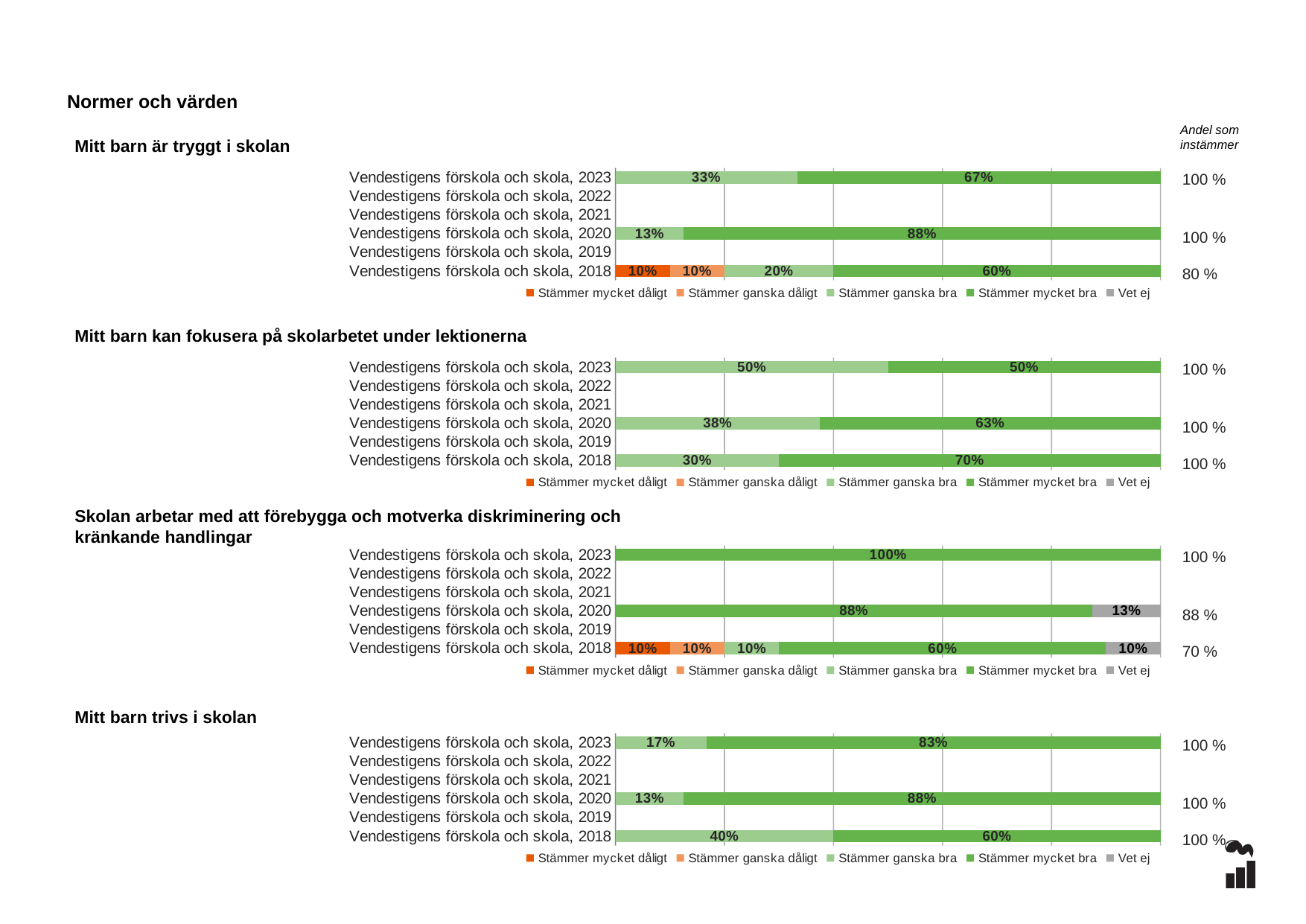
In the chart 'Mitt barn kan fokusera på skolarbetet under lektionerna', what is the value for 'Stämmer ganska bra' for Vendestigens förskola och skola, 2020? 38% In the chart 'Mitt barn trivs i skolan', what is the value for 'Stämmer ganska bra' for Vendestigens förskola och skola, 2018? 40% In the chart 'Mitt barn är tryggt i skolan', what is the value for 'Stämmer mycket bra' for Vendestigens förskola och skola, 2023? 67% In the chart 'Mitt barn kan fokusera på skolarbetet under lektionerna', what is the difference between the 'Stämmer mycket bra' values for 2018 and 2023? 20% How many series does the legend list in the chart 'Mitt barn trivs i skolan'? 5 In the chart 'Mitt barn är tryggt i skolan', what is the value for 'Stämmer mycket dåligt' for Vendestigens förskola och skola, 2018? 10% In the chart 'Mitt barn är tryggt i skolan', what is the 'Andel som instämmer' shown for Vendestigens förskola och skola, 2018? 80 % What kind of chart is 'Mitt barn är tryggt i skolan'? Stacked bar chart In the chart 'Skolan arbetar med att förebygga och motverka diskriminering och kränkande handlingar', what is the value for 'Vet ej' for Vendestigens förskola och skola, 2020? 13% In the chart 'Skolan arbetar med att förebygga och motverka diskriminering och kränkande handlingar', what is the 'Andel som instämmer' for Vendestigens förskola och skola, 2018? 70 % In the chart 'Skolan arbetar med att förebygga och motverka diskriminering och kränkande handlingar', which year has the highest 'Stämmer mycket bra' value? 2023 In the chart 'Mitt barn trivs i skolan', which is larger: the 'Stämmer mycket bra' value for 2023 or for 2018? 2023